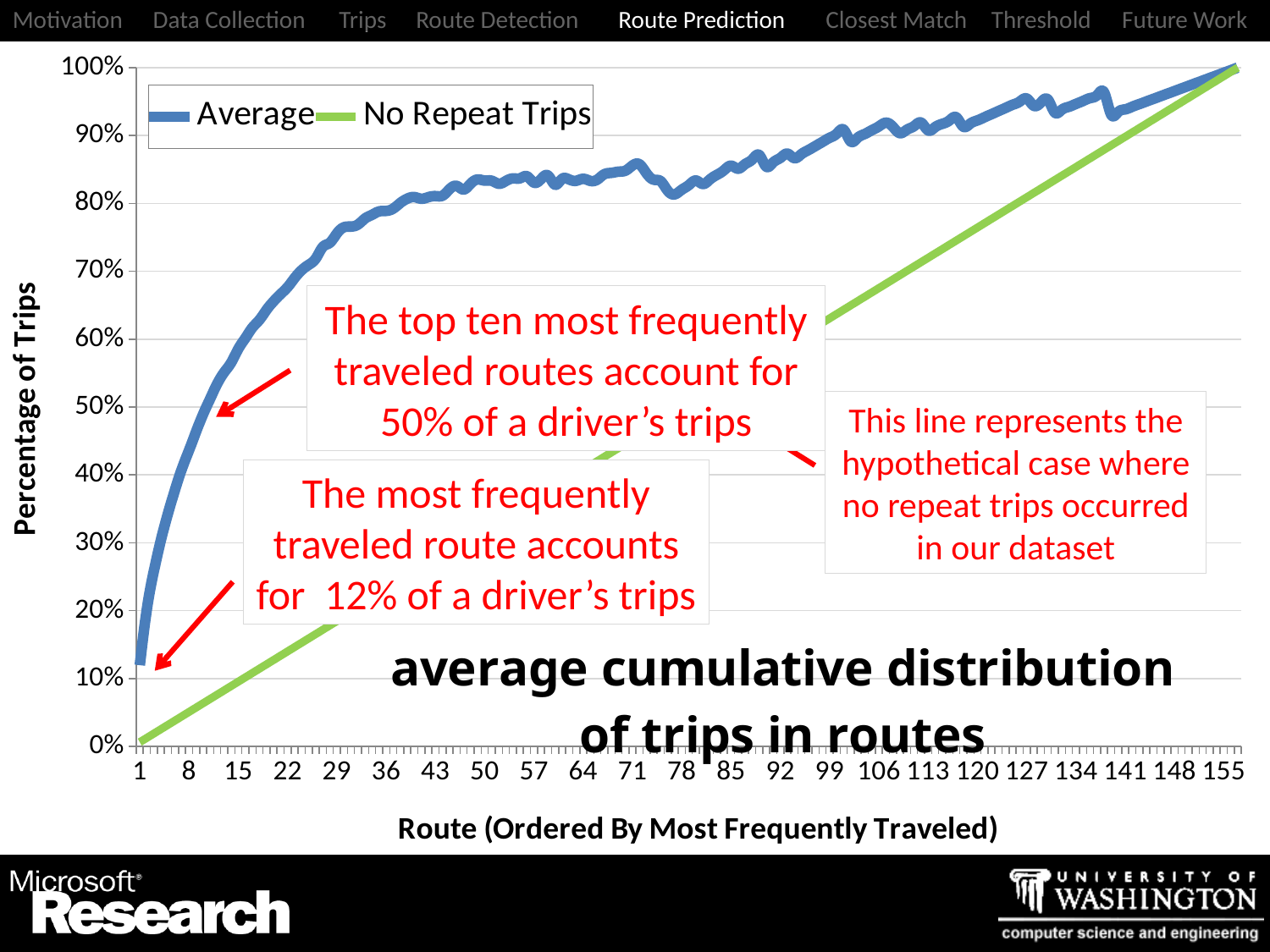
What is the title of the chart's x axis? Route (Ordered By Most Frequently Traveled) What are the two series named in the chart legend? Average and No Repeat Trips How many series does the chart legend list? 2 What kind of chart is shown on the slide? line chart Is the value of the Average series at route 22 greater or less than 70%? less Is the value of the Average series at route 50 greater or less than 80%? greater Does the Average series generally rise or fall as the route number increases along the x axis? rise According to the slide's annotation, what percentage of a driver's trips does the most frequently traveled route account for? 12% Is the value of the Average series at route 1 greater or less than 10%? greater According to the slide's annotation, what percentage of a driver's trips do the top ten most frequently traveled routes account for? 50% At route 50, which series has the higher value, Average or No Repeat Trips? Average